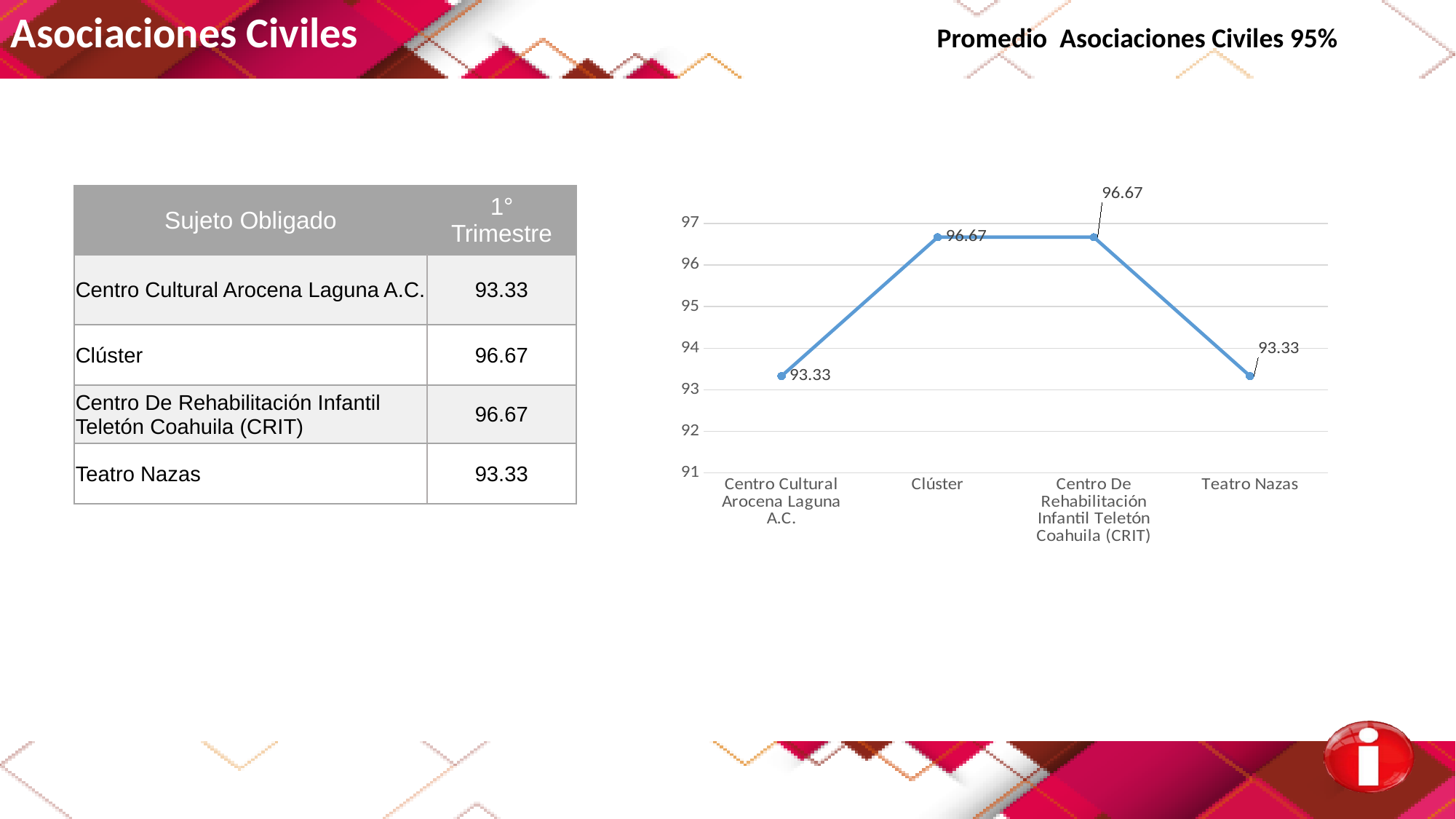
What is the value for Clúster in the chart? 96.67 What is the difference between the values for Clúster and Teatro Nazas? 3.34 What is the value for Centro Cultural Arocena Laguna A.C. in the chart? 93.33 Which is larger, the value for Clúster or the value for Centro Cultural Arocena Laguna A.C.? Clúster What is the value for Teatro Nazas in the chart? 93.33 What is the value for Centro De Rehabilitación Infantil Teletón Coahuila (CRIT) in the chart? 96.67 What is the lowest value shown on the chart's vertical axis? 91 Is the value for Centro De Rehabilitación Infantil Teletón Coahuila (CRIT) greater or less than 96? greater Does the line rise or fall between Centro De Rehabilitación Infantil Teletón Coahuila (CRIT) and Teatro Nazas? fall What kind of chart is shown on the slide? line chart Is the value for Teatro Nazas greater or less than 95? less How many categories are plotted on the x axis of the chart? 4